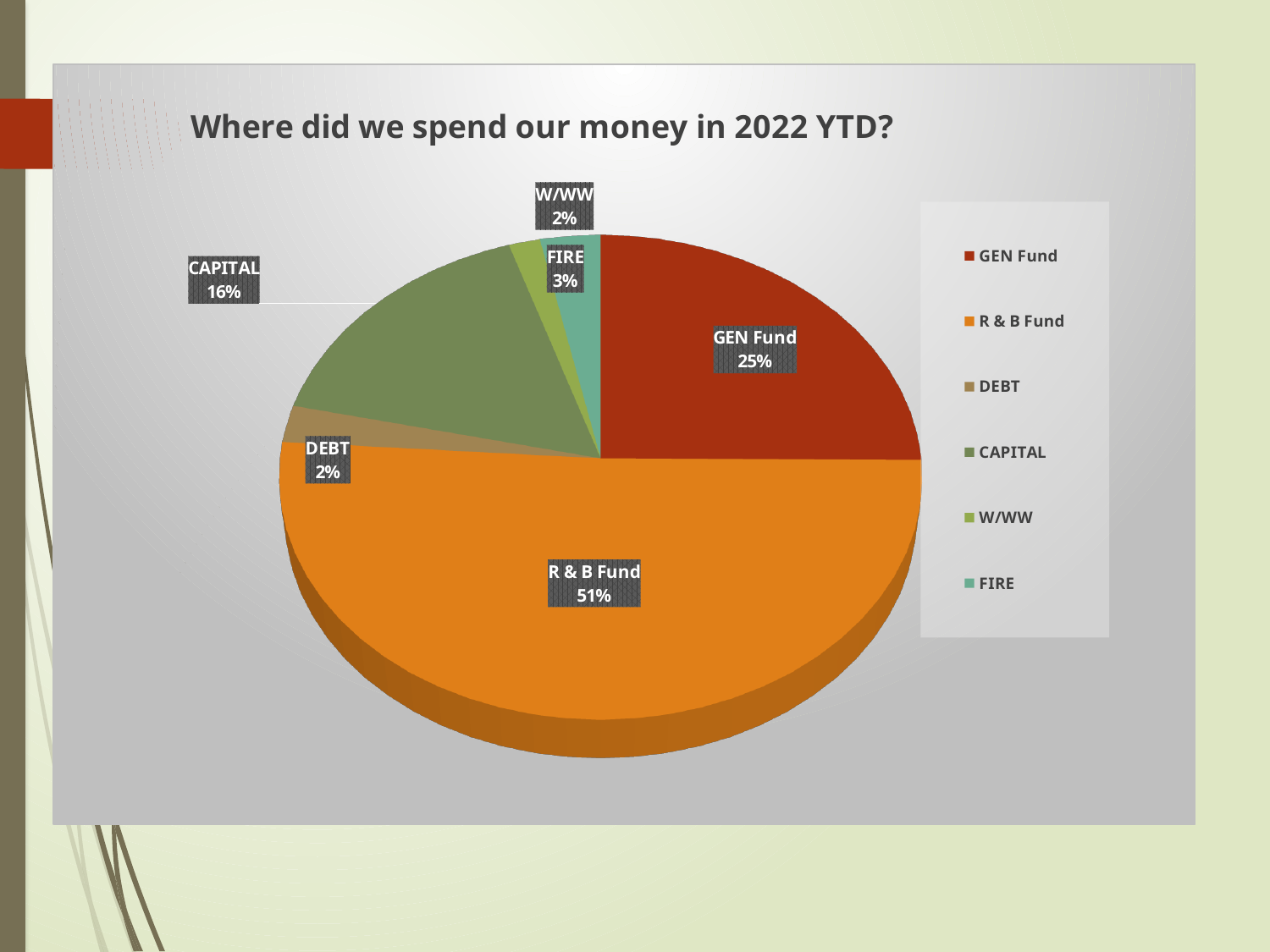
What share of spending does the R & B Fund slice represent? 51% What percentage is shown for FIRE? 3% What is the title of the chart? Where did we spend our money in 2022 YTD? What is the difference in percentage points between the R & B Fund and GEN Fund slices? 26 Which category has the largest slice of the pie? R & B Fund How many categories are shown in the pie chart? 6 What percentage is shown for the GEN Fund slice? 25% Which category is listed first in the legend? GEN Fund Which category has the larger share, GEN Fund or CAPITAL? GEN Fund What percentage is shown for CAPITAL? 16% What kind of chart is shown on the slide? Pie chart What is the difference in percentage points between CAPITAL and FIRE? 13